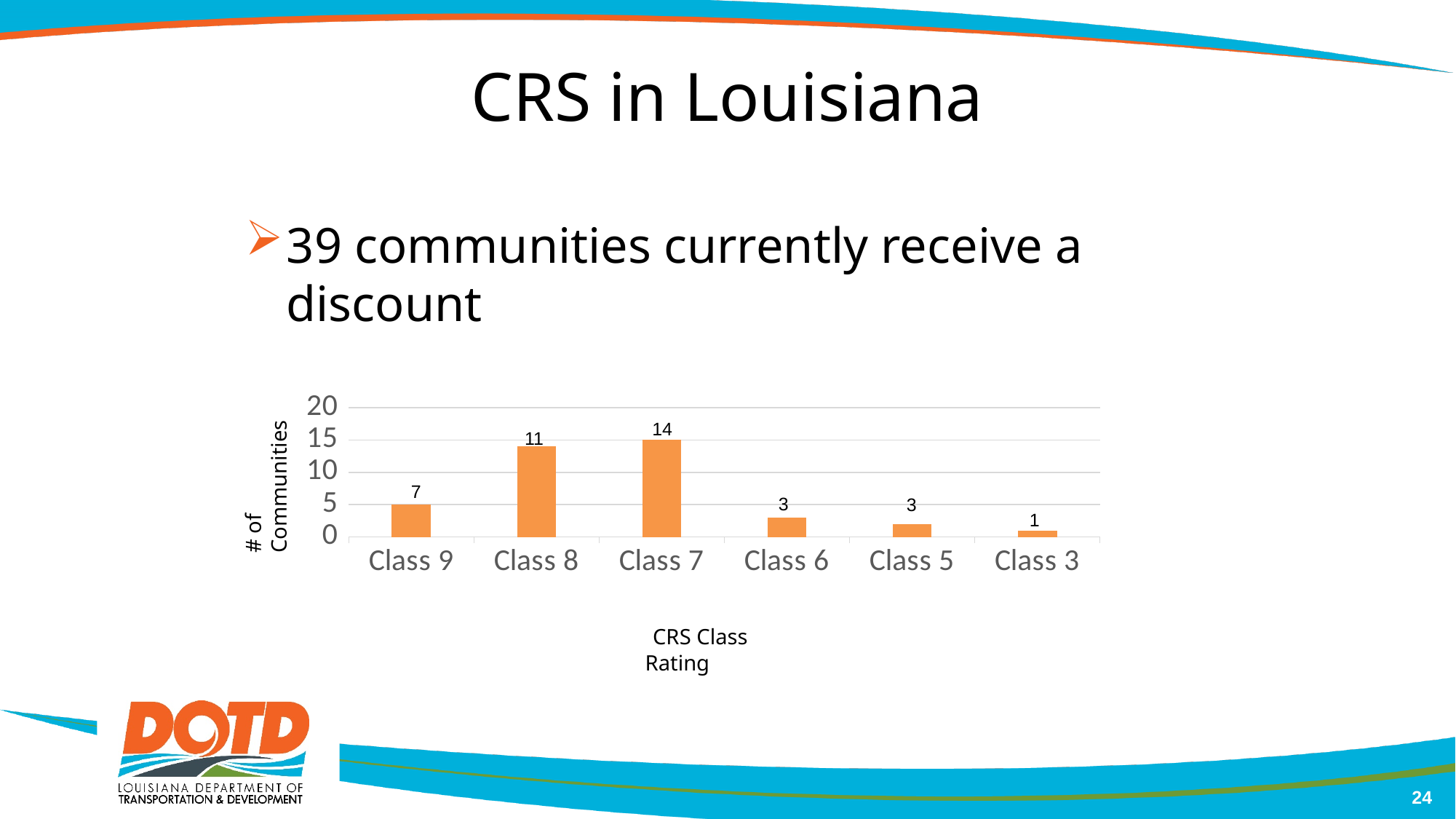
What is the difference between the number of communities in Class 7 and Class 6? 11 What is the value shown for Class 9? 7 What type of chart is shown on the slide? Bar chart How many CRS class categories are shown on the x axis? 6 Which has more communities, Class 8 or Class 9? Class 8 How many communities are in Class 7? 14 Is the value for Class 6 greater or less than 5? less What is the number of communities for Class 8? 11 How many communities are in Class 3? 1 Which CRS class has the highest number of communities? Class 7 What is the label of the vertical axis of the chart? # of Communities Which CRS class has the lowest number of communities? Class 3